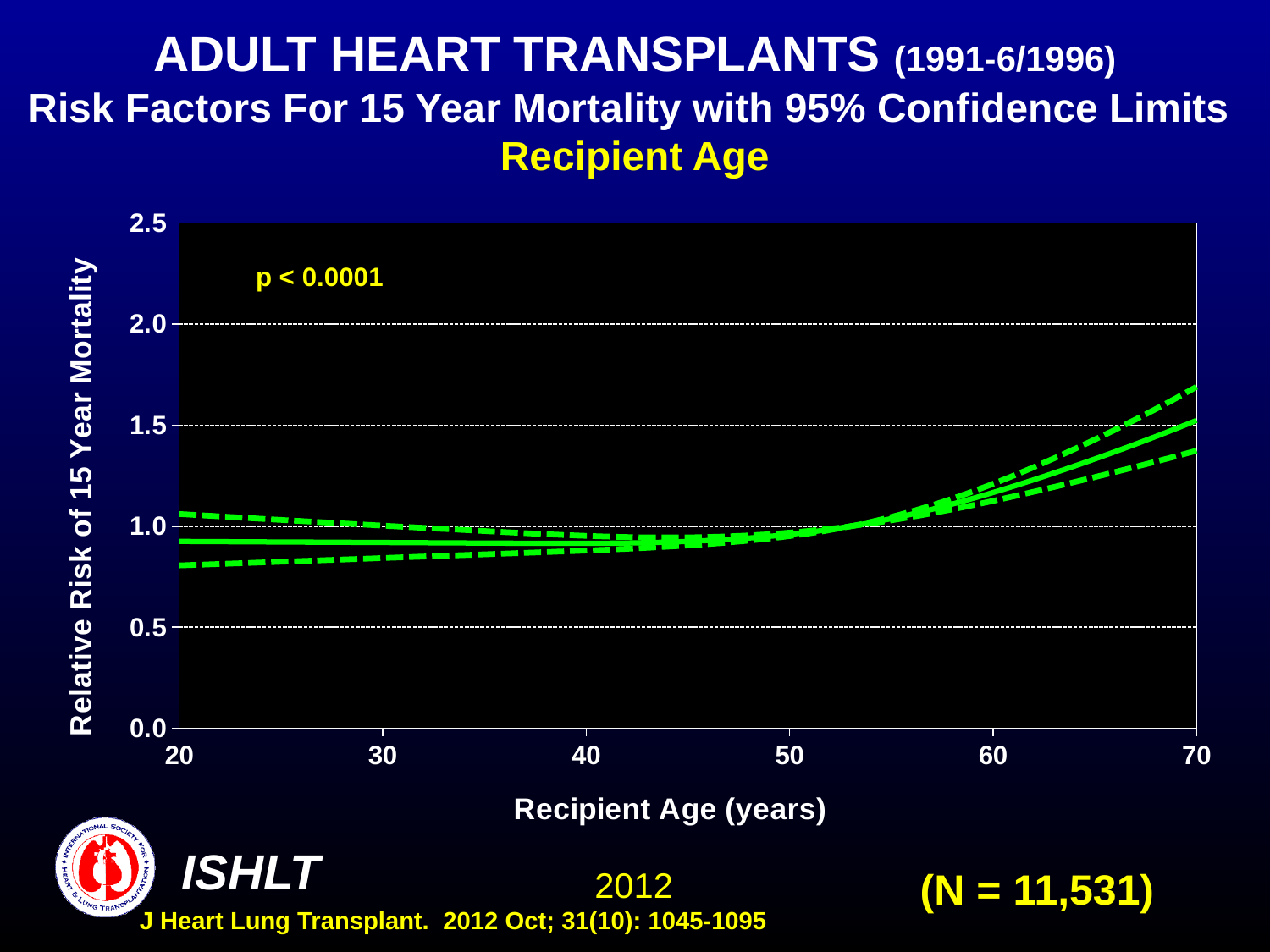
Which recipient age has the higher relative risk on the solid line, 30 or 70? 70 How many lines are plotted on the chart? 3 What is the sample size (N) shown on the slide? N = 11,531 Is the lower confidence limit (lower dashed line) at recipient age 20 greater or less than 1.0? less Is the relative risk shown by the solid line at recipient age 70 greater or less than 2.0? less Is the relative risk shown by the solid line at recipient age 70 greater or less than 1.0? greater What p-value is printed on the chart? p < 0.0001 What kind of chart is shown on the slide? line chart Does the relative risk of 15 year mortality rise or fall as recipient age increases from 50 to 70 years? rise